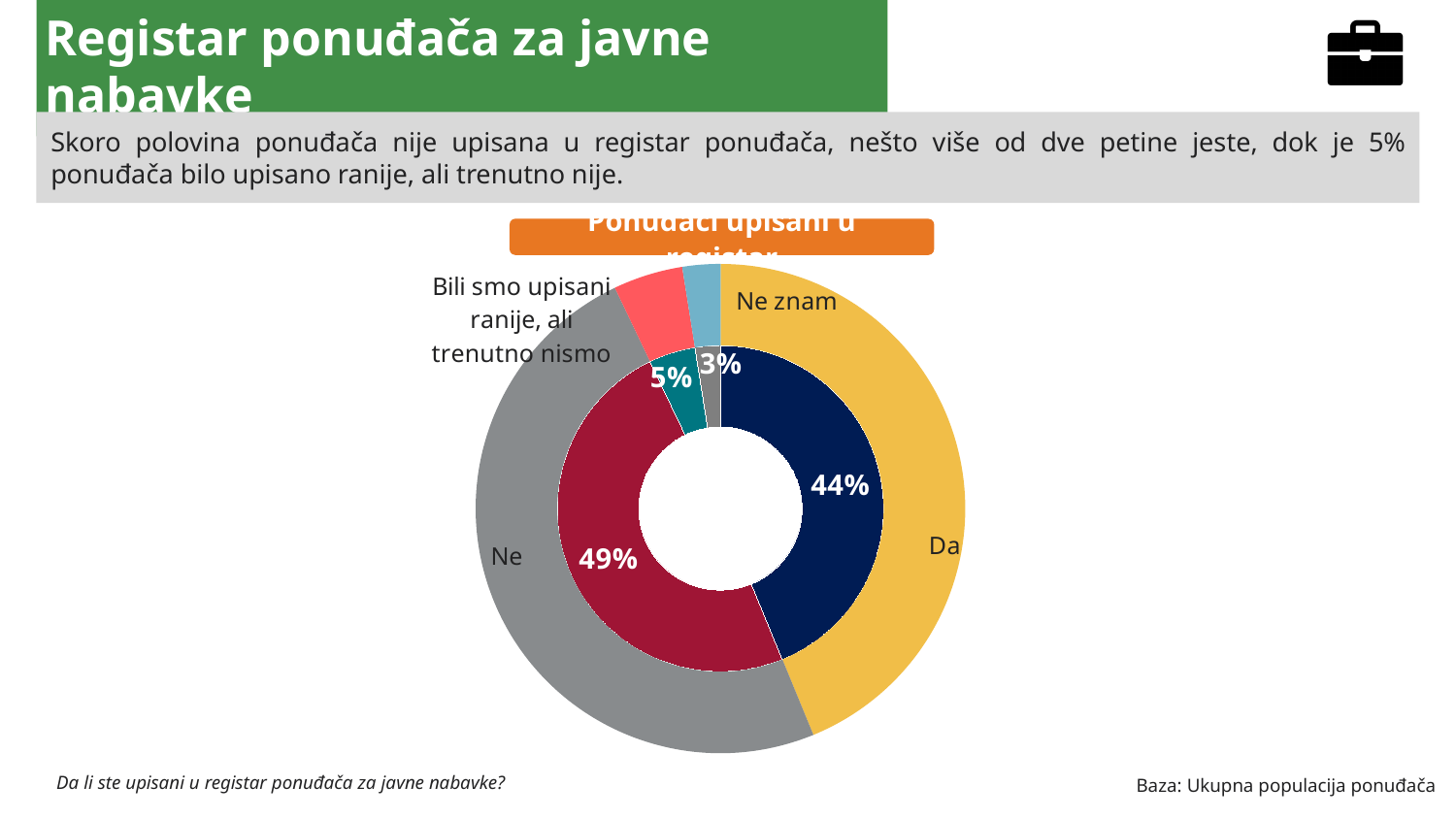
What is the combined share of "Bili smo upisani ranije, ali trenutno nismo" and "Ne znam"? 8% Which category has the largest share in the chart? Ne What percentage of bidders answered "Da" in the chart? 44% What is the difference in percentage points between "Ne" and "Da"? 5 Which is larger, the share for "Da" or the share for "Ne"? Ne What percentage of bidders answered "Bili smo upisani ranije, ali trenutno nismo"? 5% What kind of chart is shown on the slide? Doughnut (pie) chart Which category has the smallest share in the chart? Ne znam What percentage of bidders answered "Ne znam"? 3% What percentage of bidders answered "Ne" in the chart? 49% What is the title of the chart? Ponuđači upisani u registar How many categories are shown in the chart? 4